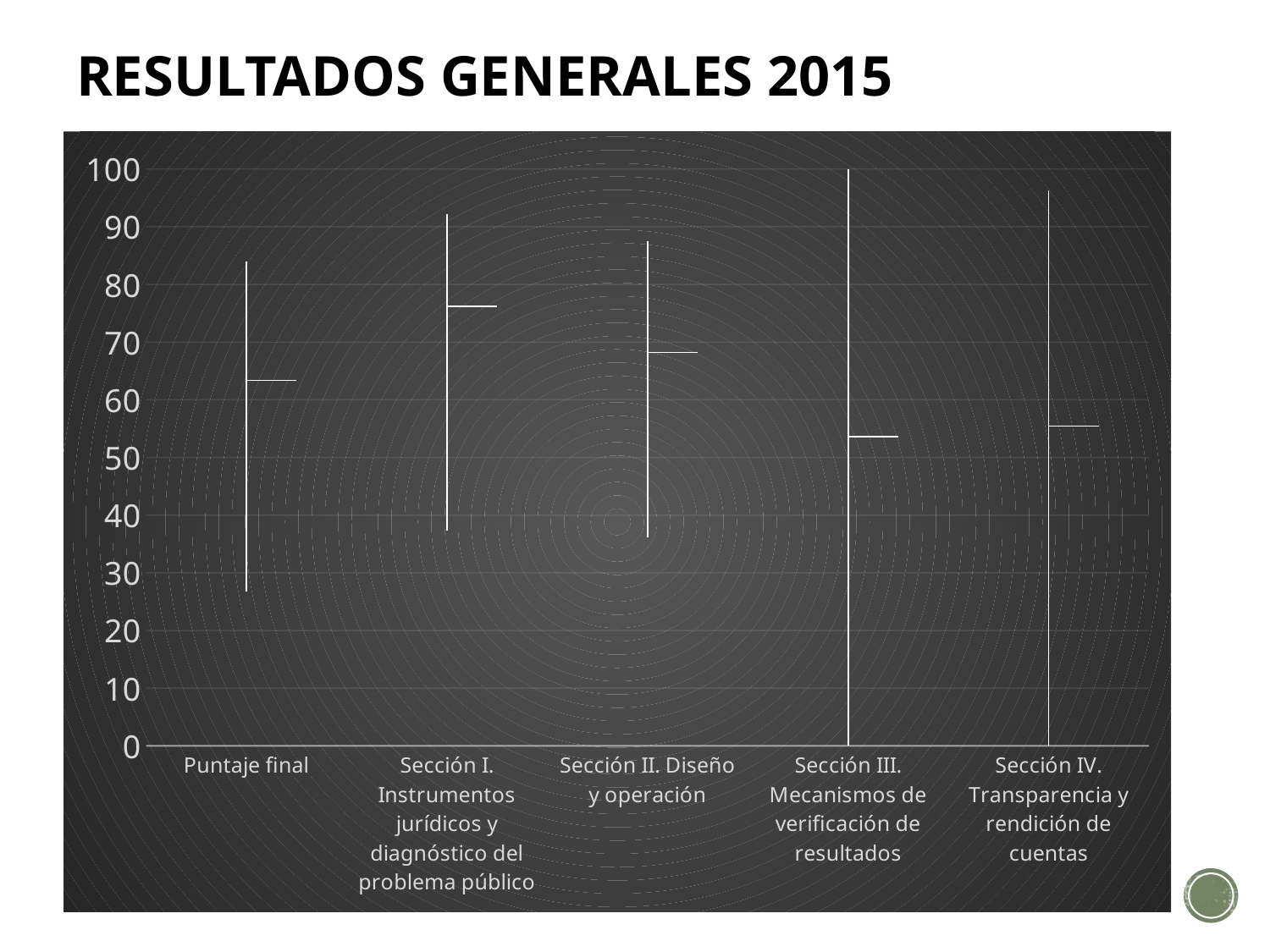
Which category's vertical line reaches the highest value on the axis? Sección III. Mecanismos de verificación de resultados Is the top of the vertical line for Sección IV. Transparencia y rendición de cuentas greater or less than 90? greater Is the bottom of the vertical line for Sección II. Diseño y operación greater or less than 40? less Which category has the highest horizontal tick mark (close value)? Sección I. Instrumentos jurídicos y diagnóstico del problema público What is the highest value shown on the vertical axis of the chart? 100 What is the title of the slide containing the chart? RESULTADOS GENERALES 2015 Which has the larger horizontal tick mark (close value): Puntaje final or Sección I. Instrumentos jurídicos y diagnóstico del problema público? Sección I. Instrumentos jurídicos y diagnóstico del problema público Is the horizontal tick mark (close value) for Sección III. Mecanismos de verificación de resultados greater or less than 50? greater How many categories are shown on the x axis of the chart? 5